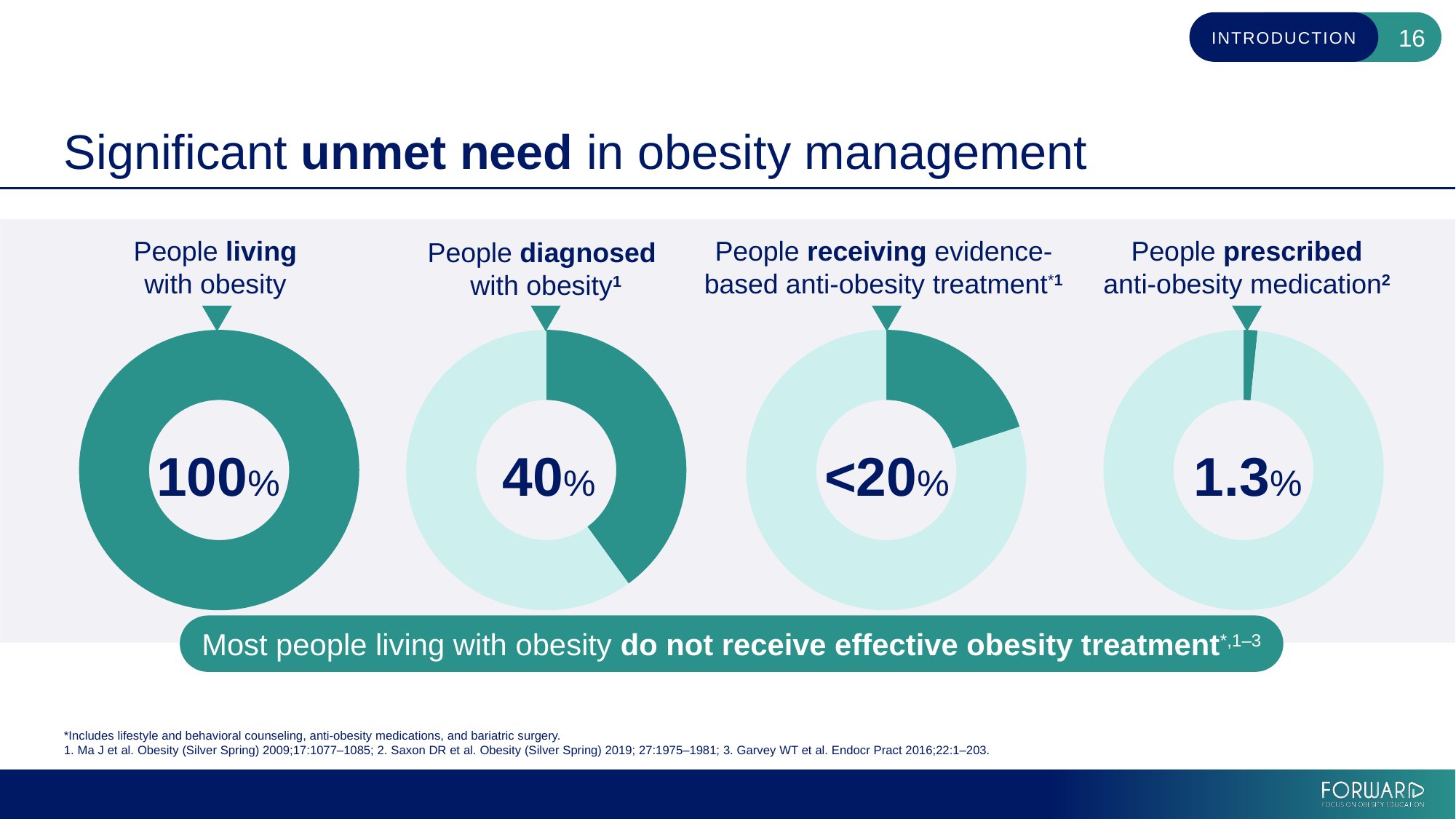
Which donut chart shows the highest percentage? People living with obesity What is the title of the slide containing the donut charts? Significant unmet need in obesity management Which donut chart shows the lowest percentage? People prescribed anti-obesity medication What percentage is shown in the donut chart for people diagnosed with obesity? 40% What is the difference in percentage points between people living with obesity (100%) and people diagnosed with obesity (40%)? 60 percentage points Which is larger: the percentage of people diagnosed with obesity or the percentage of people prescribed anti-obesity medication? People diagnosed with obesity Do the percentages rise or fall moving from the leftmost donut chart to the rightmost? Fall What kind of charts are used on this slide? Donut (pie) charts How many donut charts are shown on the slide? 4 What percentage is shown in the donut chart for people prescribed anti-obesity medication? 1.3% What value is shown in the donut chart for people receiving evidence-based anti-obesity treatment? <20% What percentage is shown in the donut chart for people living with obesity? 100%